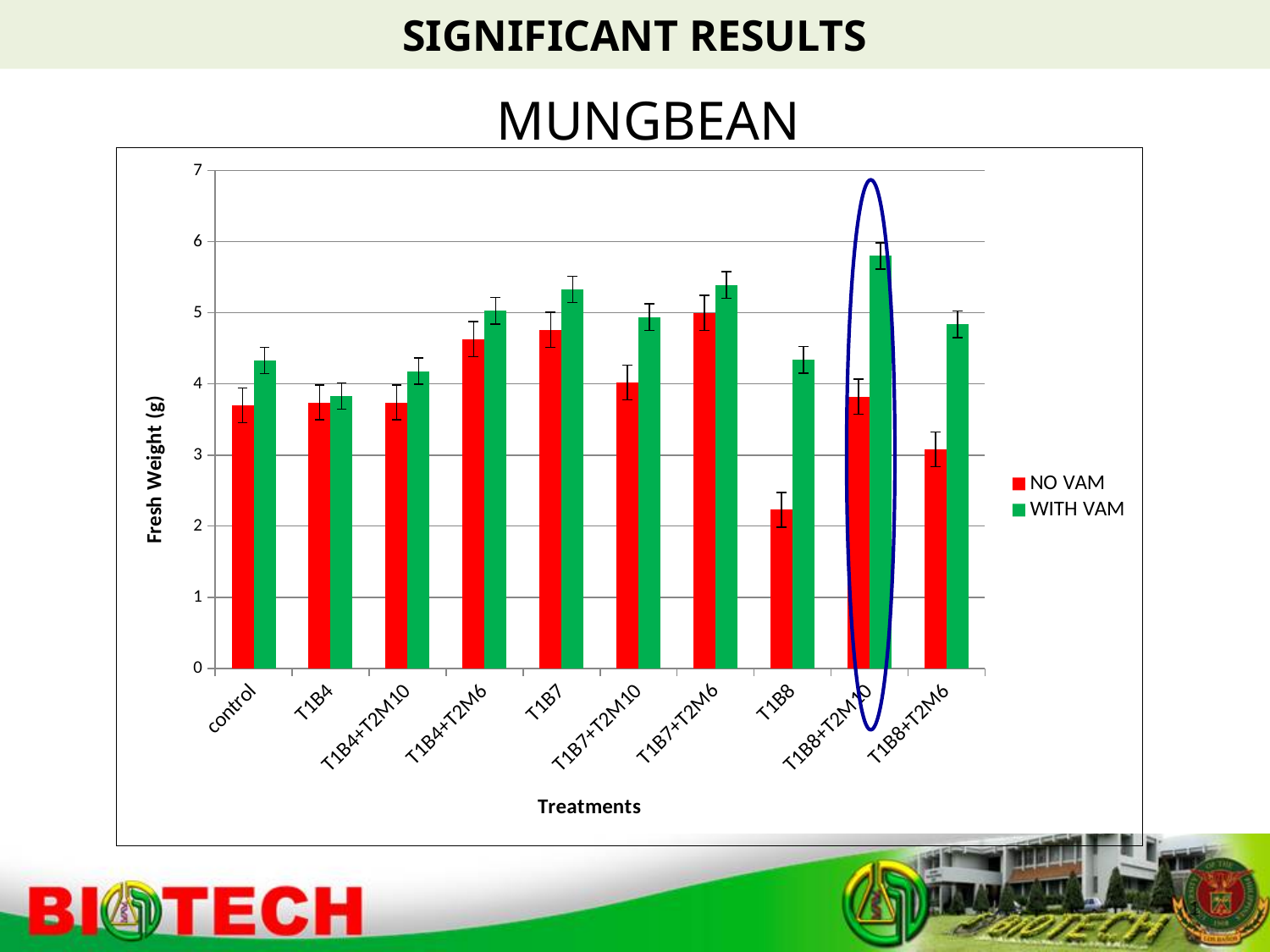
Which treatment has the lowest NO VAM fresh weight? T1B8 What kind of chart is shown on the slide? bar chart Is the WITH VAM value for T1B8+T2M10 greater or less than 5? greater For T1B8, which is larger: the NO VAM value or the WITH VAM value? WITH VAM How many series does the legend list? 2 Is the NO VAM value for T1B4+T2M6 greater or less than 4? greater Which is larger: the NO VAM value for T1B7 or the NO VAM value for T1B8? T1B7 Which treatment has the highest WITH VAM fresh weight? T1B8+T2M10 Is the WITH VAM value for control greater or less than 4? greater What is the label of the y axis? Fresh Weight (g) How many treatments are shown on the x axis? 10